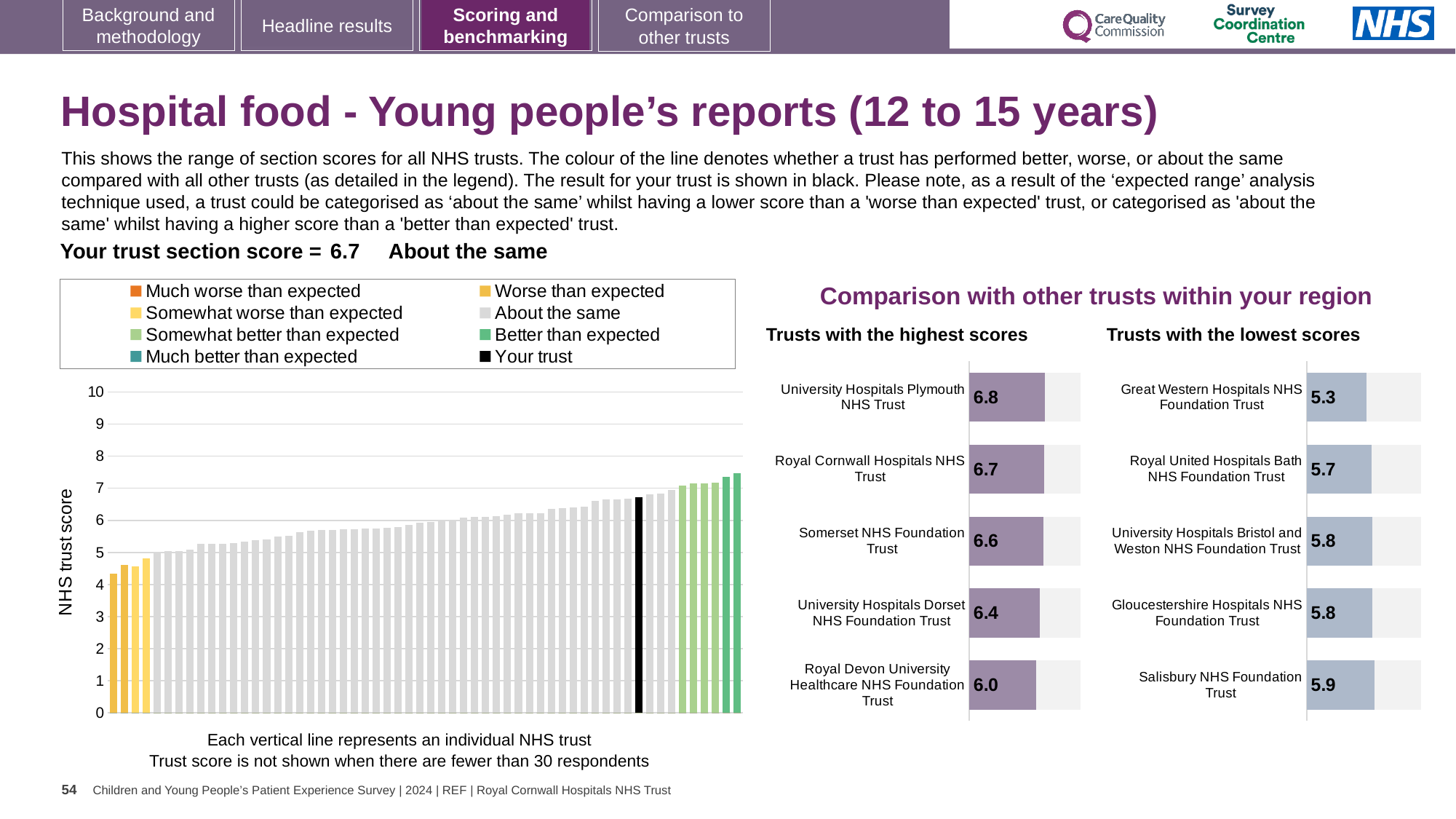
In the 'Trusts with the lowest scores' chart, which trust has the highest score? Salisbury NHS Foundation Trust How many trusts are shown in the 'Trusts with the highest scores' chart? 5 In the NHS trust score chart on the left, do the bar values rise or fall from left to right? Rise How many entries does the legend of the NHS trust score chart on the left list? 8 In the 'Trusts with the highest scores' chart, which trust has the lowest score? Royal Devon University Healthcare NHS Foundation Trust In the 'Trusts with the highest scores' chart, what is the score for University Hospitals Plymouth NHS Trust? 6.8 In the 'Trusts with the lowest scores' chart, what is the difference between the scores of Salisbury NHS Foundation Trust and Great Western Hospitals NHS Foundation Trust? 0.6 What kind of chart is the NHS trust score chart on the left of the slide? Bar chart In the 'Trusts with the lowest scores' chart, which has the larger score: Royal United Hospitals Bath NHS Foundation Trust or Salisbury NHS Foundation Trust? Salisbury NHS Foundation Trust In the 'Trusts with the highest scores' chart, what is the difference between the scores of University Hospitals Plymouth NHS Trust and Royal Devon University Healthcare NHS Foundation Trust? 0.8 In the 'Trusts with the lowest scores' chart, what is the score for Great Western Hospitals NHS Foundation Trust? 5.3 In the NHS trust score chart on the left, is the value of the leftmost bar greater or less than 5? less